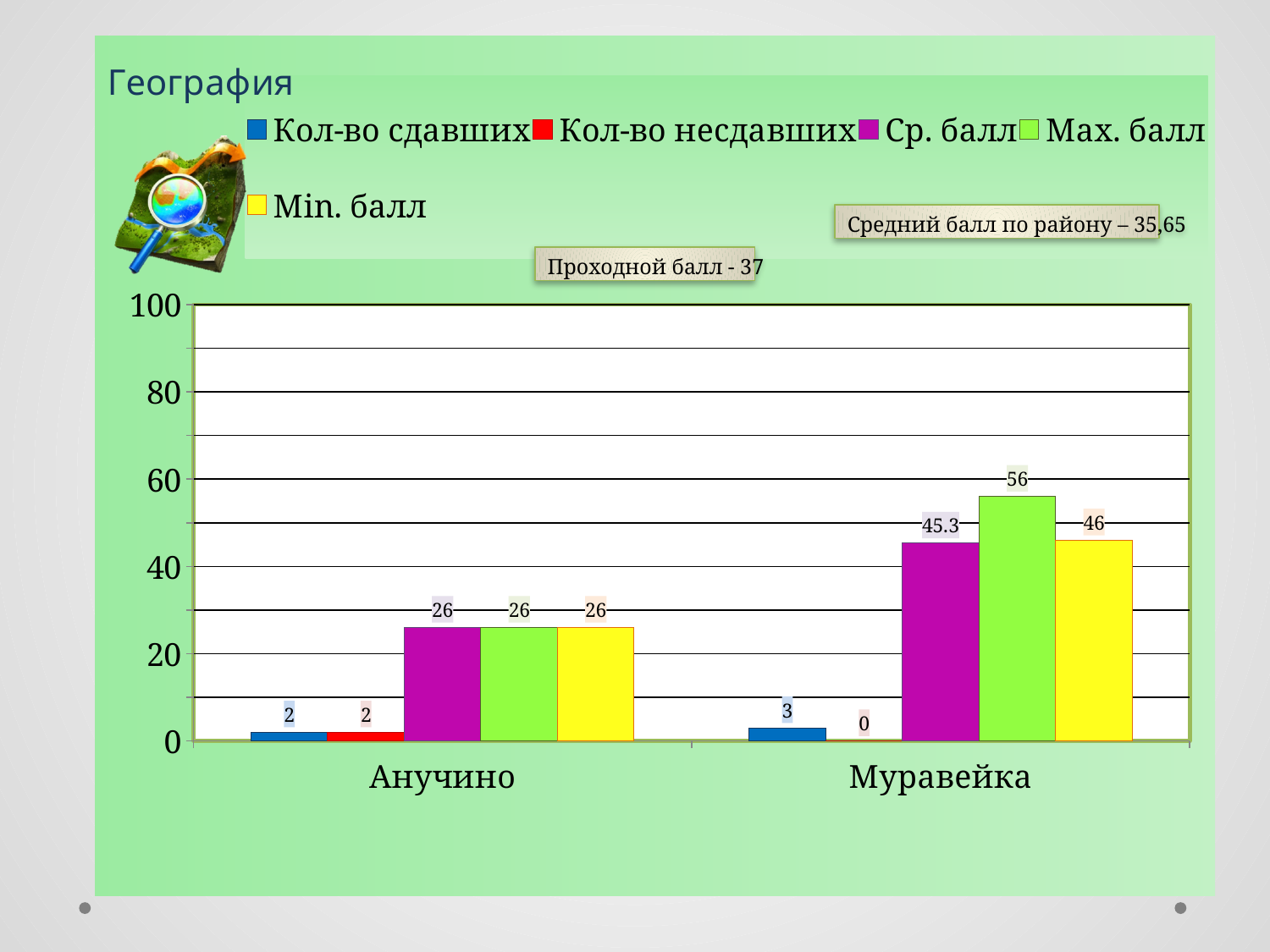
What is the value of Max. балл for Анучино? 26 Which is larger: Кол-во сдавших for Анучино or Кол-во сдавших for Муравейка? Кол-во сдавших for Муравейка Which category has the higher Max. балл? Муравейка What is the value of Ср. балл for Муравейка? 45.3 What is the value of Кол-во сдавших for Муравейка? 3 What is the value of Кол-во несдавших for Муравейка? 0 What kind of chart is shown on the slide? bar chart Is the value of Max. балл for Муравейка greater or less than 60? less What is the difference between Max. балл for Муравейка and Max. балл for Анучино? 30 How many categories are shown on the x axis? 2 How many series does the legend list? 5 What is the difference between Min. балл for Муравейка and Ср. балл for Муравейка? 0.7